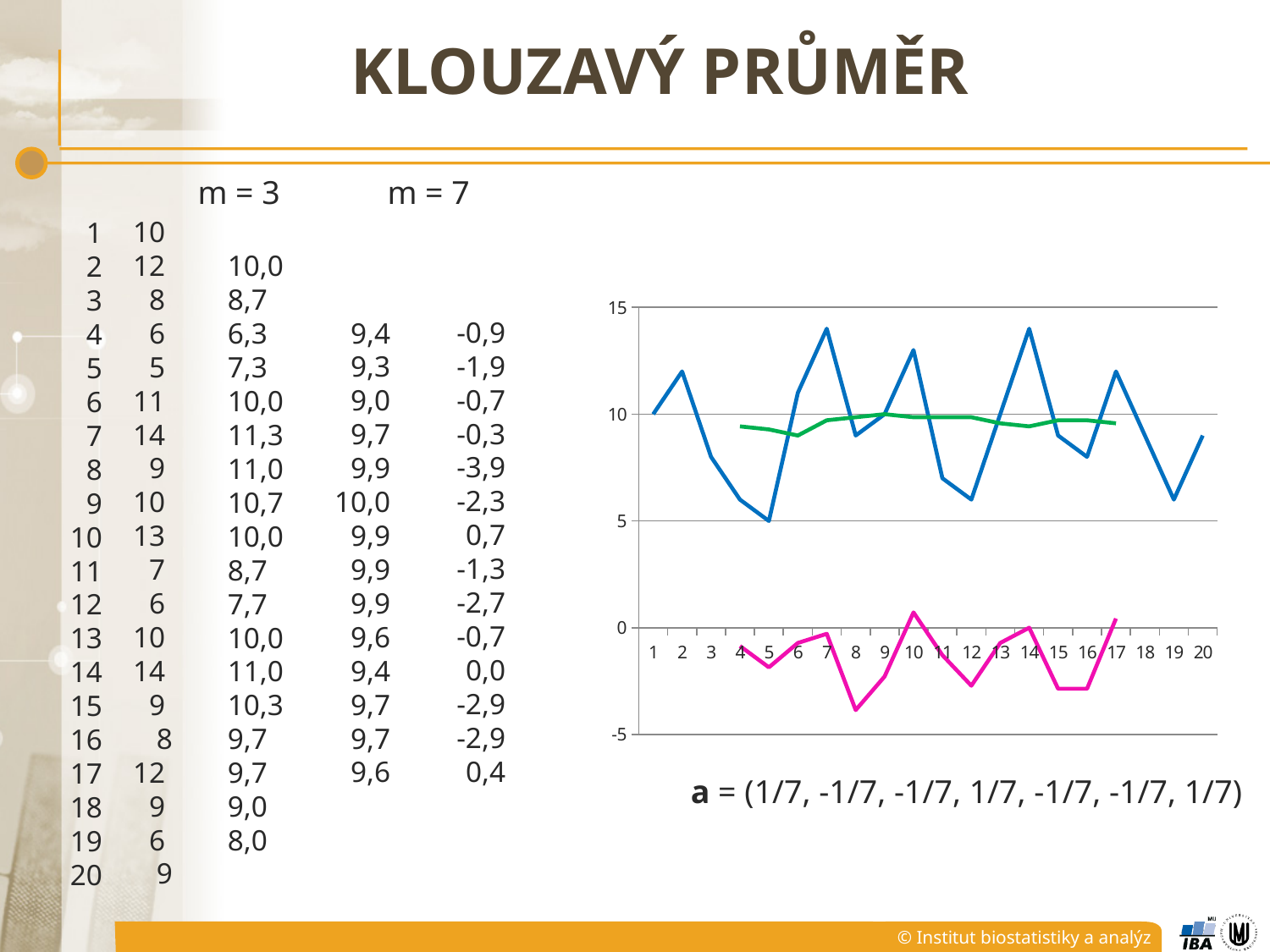
At which x value does the magenta line reach its lowest point? 8 How many lines are plotted in the chart? 3 Does the blue line rise or fall from x = 2 to x = 5? fall At which x value does the blue line reach its lowest point? 5 What kind of chart is shown on the slide? line chart What is the value of the blue line at x = 5? 5 What is the value of the blue line at x = 1? 10 Is the value of the green line at x = 4 greater or less than 10? less Which line is higher at x = 12, the blue line or the green line? green Is the value of the blue line at x = 7 greater or less than 10? greater How many points are labelled along the x axis of the chart? 20 Is the value of the magenta line at x = 8 greater or less than 0? less